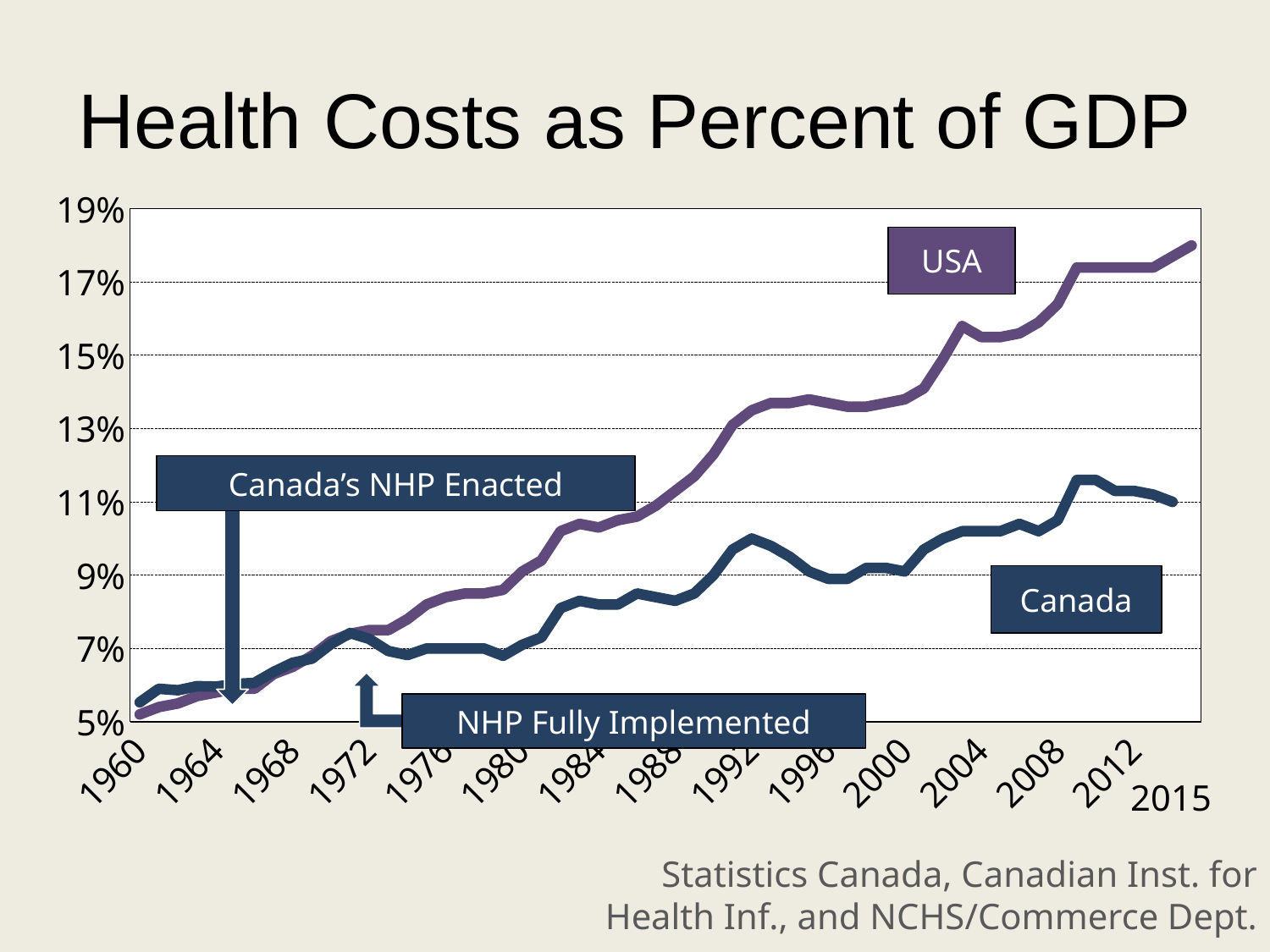
Is the value for Canada in 1976 greater or less than 9%? less Is the value for the USA in 2015 greater or less than 17%? greater What is the title of the chart? Health Costs as Percent of GDP In 2015, which series has the higher value, USA or Canada? USA Which two countries are plotted on the chart? USA and Canada Is the value for the USA in 2000 greater or less than 13%? greater How many series are plotted on the chart? 2 Does the USA series generally rise or fall from 1960 to 2015? rise Which series has the higher value in 2008, USA or Canada? USA What kind of chart is shown on the slide? line chart